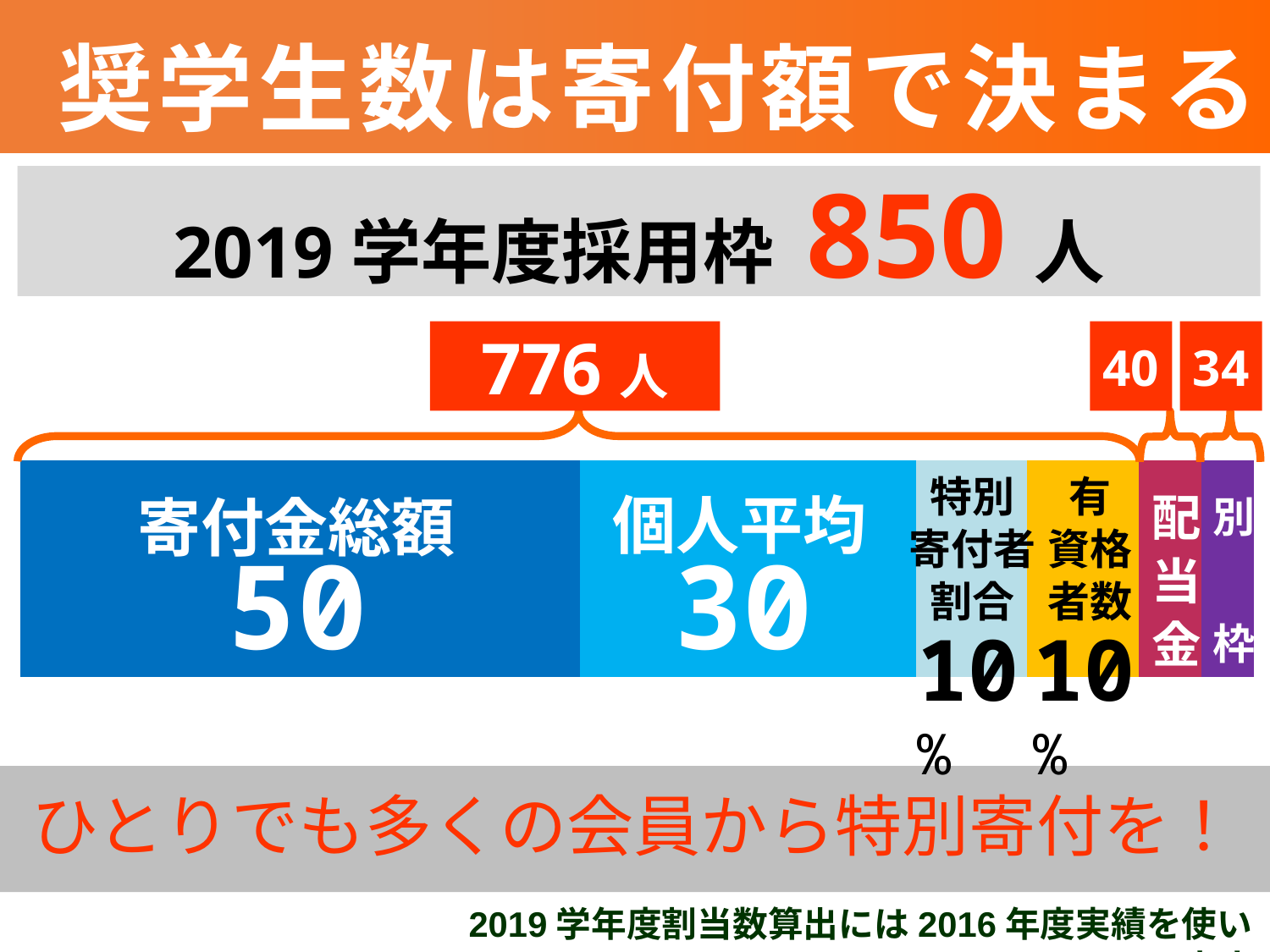
What value is shown for the 特別寄付者割合 segment? 10% What kind of chart is shown on the slide? Bar chart How many people (人) does the bracket over the first four segments of the bar indicate? 776 人 What is the difference between the 寄付金総額 value (50) and the 個人平均 value (30)? 20 What is the value shown for the 寄付金総額 segment of the bar? 50 What is the difference between the 2019 学年度採用枠 total of 850 人 and the 776 人 bracket? 74 Which is larger, the value for 寄付金総額 or the value for 個人平均? 寄付金総額 What number is shown above the 別枠 segment? 34 What is the value shown for the 個人平均 segment of the bar? 30 Which segment of the bar has the largest labelled value? 寄付金総額 How many coloured segments make up the horizontal bar? 6 What number is shown above the 配当金 segment? 40